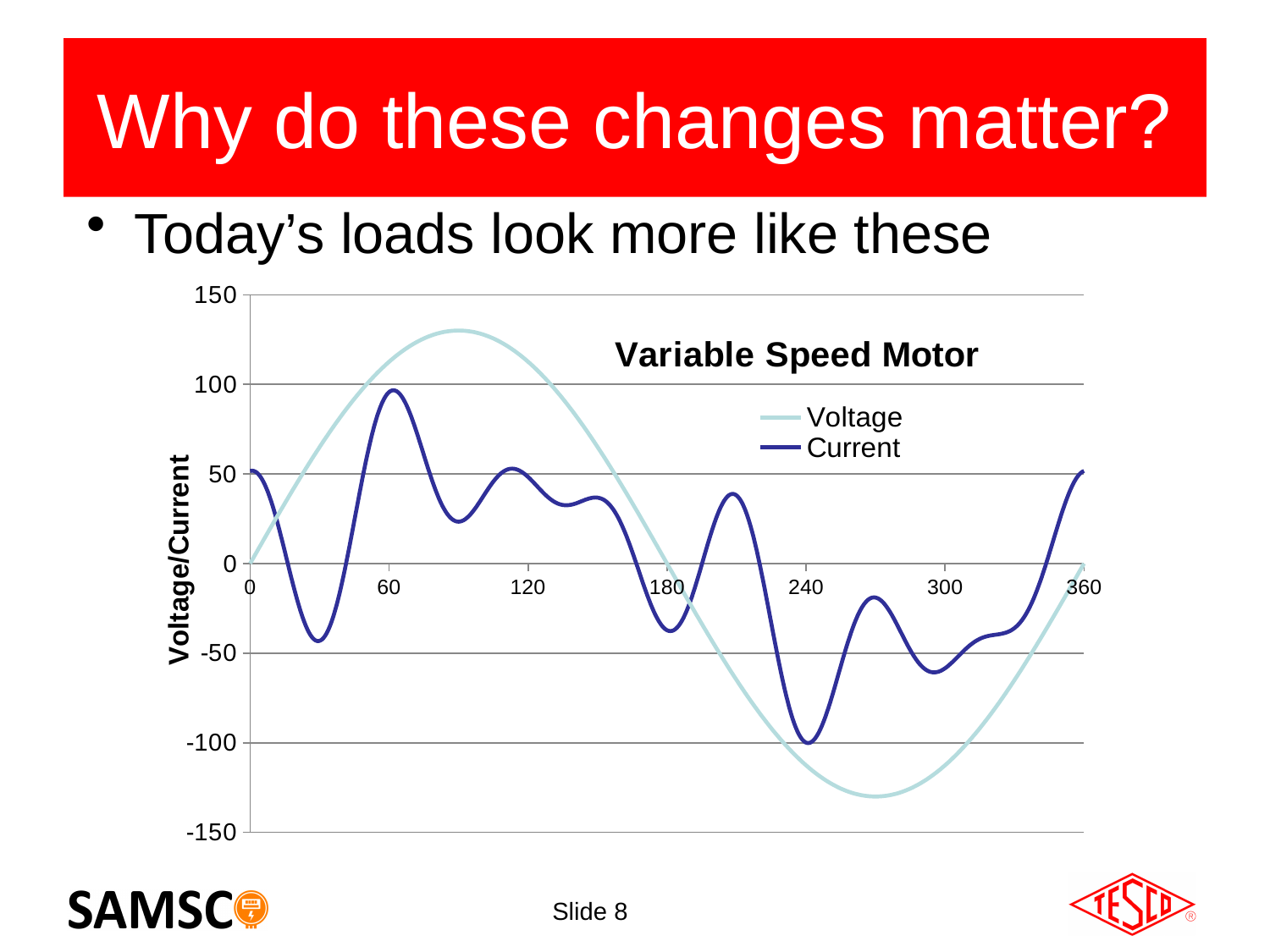
At 270 on the x axis, which series has the larger value, Voltage or Current? Current How many series does the legend list? 2 Does the Voltage series rise or fall between 90 and 270 on the x axis? fall Is the Current value at 240 greater or less than -50? less Is the Voltage value at 270 greater or less than -100? less Is the Current value at 60 greater or less than 50? greater Does the Voltage series rise or fall between 0 and 90 on the x axis? rise What kind of chart is shown on the slide? line chart At 90 on the x axis, which series has the larger value, Voltage or Current? Voltage What are the two series named in the legend? Voltage and Current What is the title of the chart? Variable Speed Motor